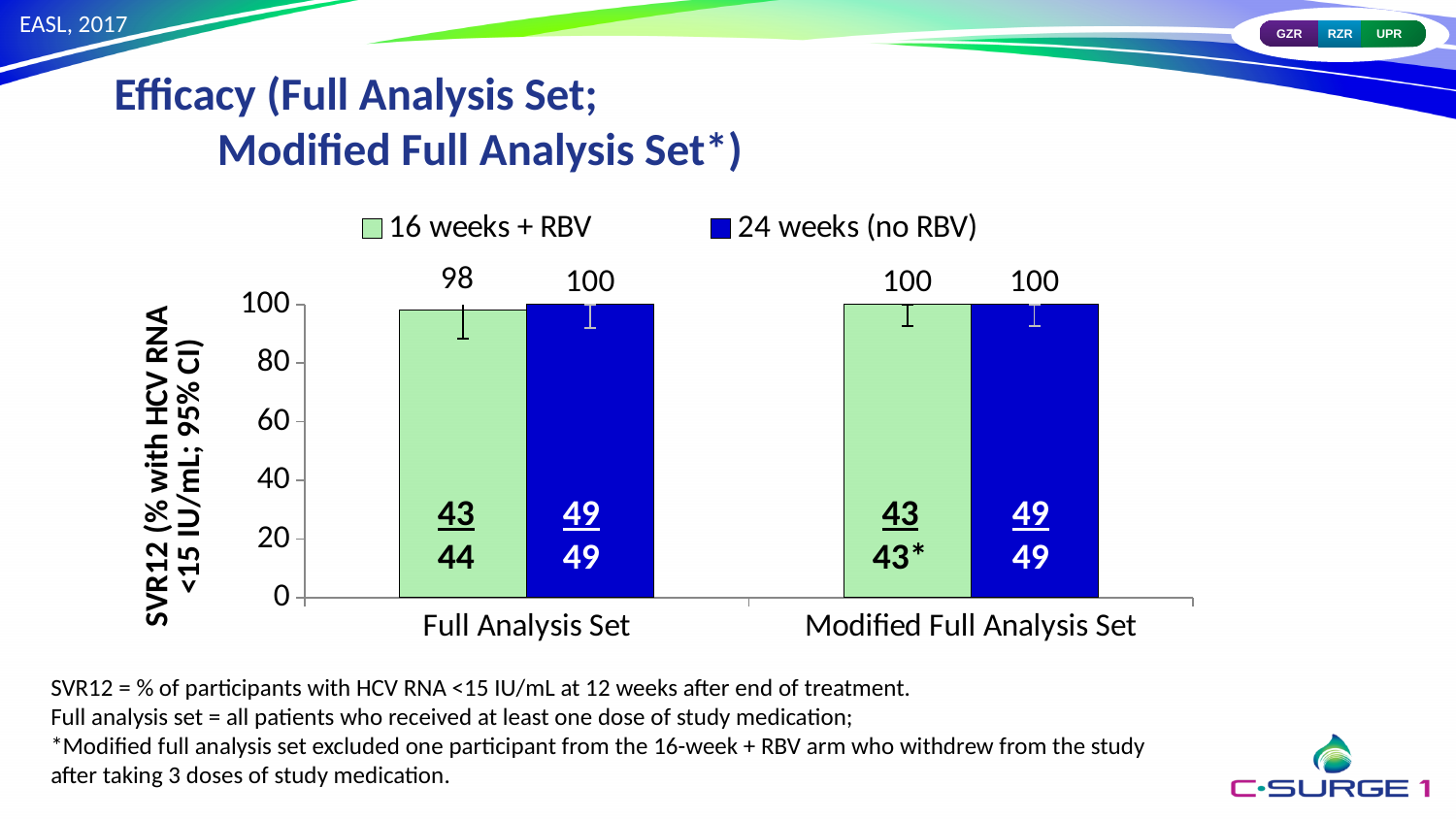
What kind of chart is shown on the slide? Bar chart What is the SVR12 value for the 24 weeks (no RBV) arm in the Full Analysis Set? 100 In the Full Analysis Set, which arm has the higher SVR12 value, 16 weeks + RBV or 24 weeks (no RBV)? 24 weeks (no RBV) How many categories are shown on the x axis? 2 What is the SVR12 value for the 16 weeks + RBV arm in the Full Analysis Set? 98 What is the SVR12 value for the 16 weeks + RBV arm in the Modified Full Analysis Set? 100 How many series does the legend list? 2 What is the SVR12 value for the 24 weeks (no RBV) arm in the Modified Full Analysis Set? 100 What fraction is printed inside the 16 weeks + RBV bar for the Full Analysis Set? 43/44 What is the difference between the 24 weeks (no RBV) and 16 weeks + RBV SVR12 values in the Full Analysis Set? 2 Which bar has the lowest SVR12 value on the chart? 16 weeks + RBV in the Full Analysis Set What is the label of the y axis? SVR12 (% with HCV RNA <15 IU/mL; 95% CI)